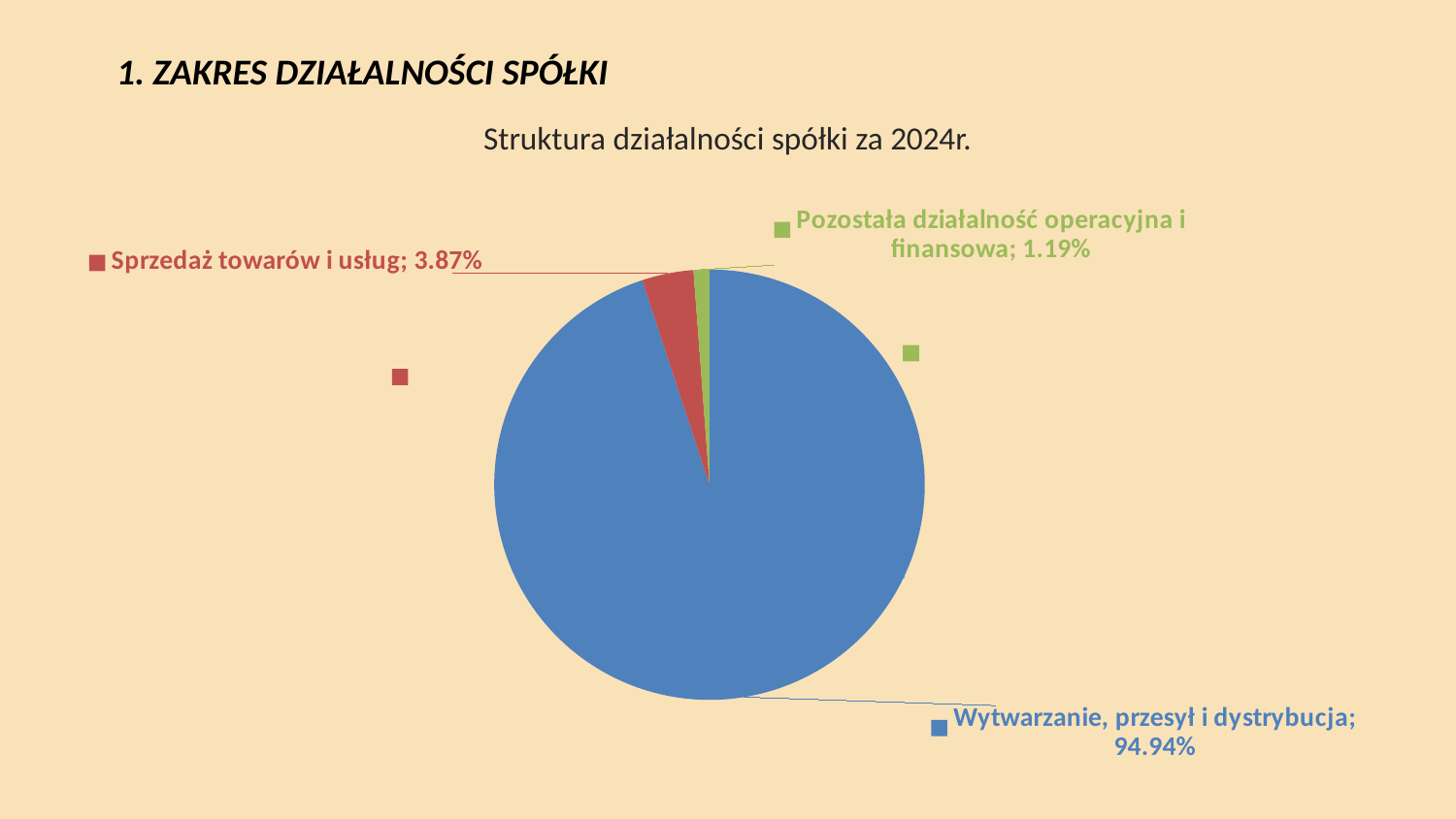
Which category has the smallest slice of the pie? Pozostała działalność operacyjna i finansowa Which is larger: the share for Sprzedaż towarów i usług or the share for Pozostała działalność operacyjna i finansowa? Sprzedaż towarów i usług What is the share for Sprzedaż towarów i usług? 3.87% How many slices does the pie chart have? 3 What is the share for Pozostała działalność operacyjna i finansowa? 1.19% What colour is the slice for Wytwarzanie, przesył i dystrybucja? blue Which category has the largest slice of the pie? Wytwarzanie, przesył i dystrybucja What is the difference in percentage points between Wytwarzanie, przesył i dystrybucja and Sprzedaż towarów i usług? 91.07 What is the share for Wytwarzanie, przesył i dystrybucja? 94.94% What kind of chart is shown on the slide? pie chart What is the difference in percentage points between Sprzedaż towarów i usług and Pozostała działalność operacyjna i finansowa? 2.68 What is the title of the chart? Struktura działalności spółki za 2024r.